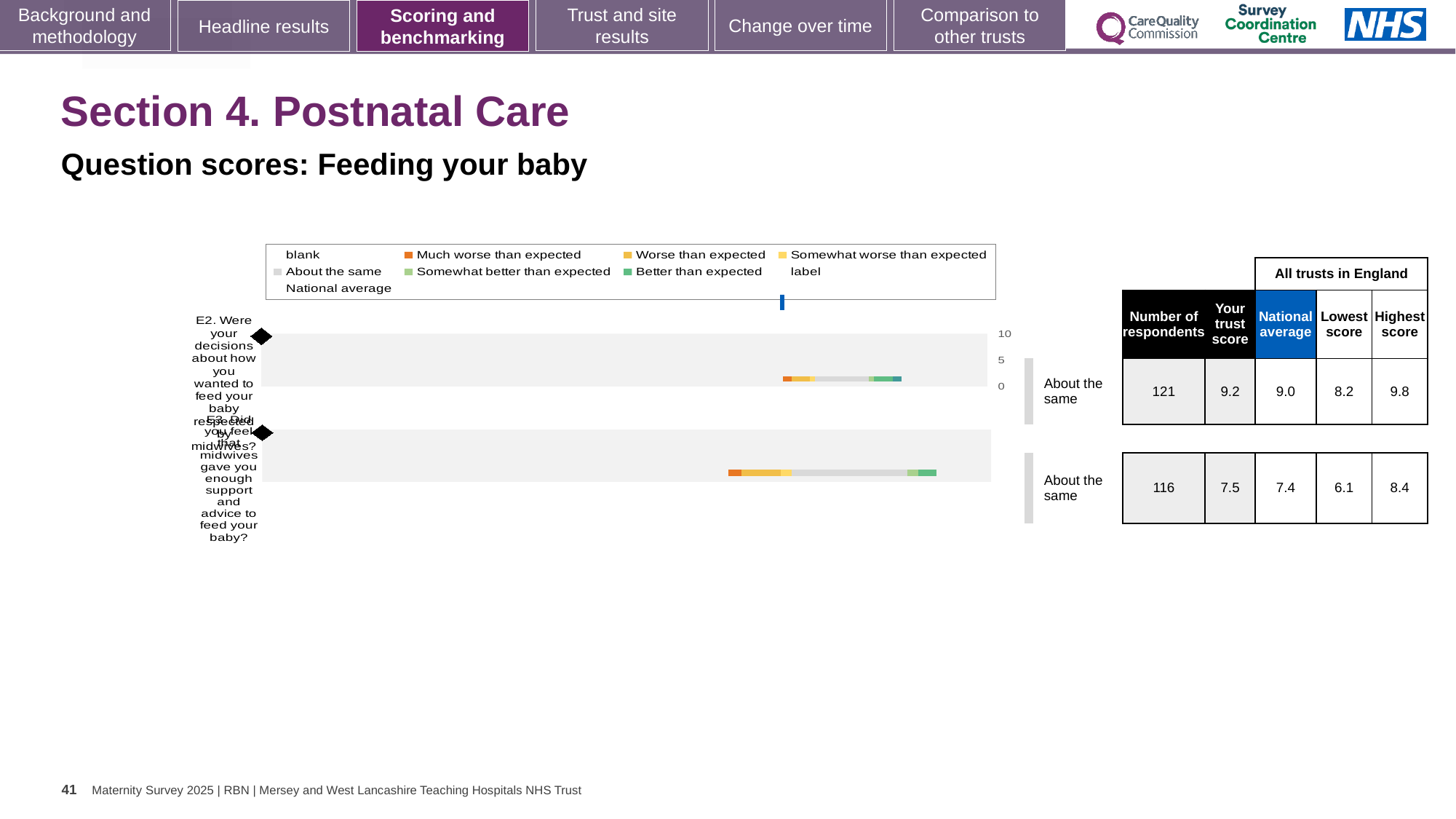
Which is larger for question E2: the trust score or the national average? trust score What is the highest score among all trusts in England for question E3? 8.4 Which legend entry is shown in orange? Much worse than expected What kind of chart is used to show the question scores for Feeding your baby? bar chart What is the trust score for question E2 about decisions on how you wanted to feed your baby being respected by midwives? 9.2 How many questions (categories) are plotted in the Feeding your baby chart? 2 What is the difference between the highest and lowest scores across all trusts in England for question E2? 1.6 What is the national average for question E3 about midwives giving enough support and advice to feed your baby? 7.4 Which question has the higher trust score, E2 or E3? E2 How many respondents answered question E2? 121 What benchmark category is shown for both E2 and E3? About the same What is the difference between the highest and lowest scores across all trusts in England for question E3? 2.3